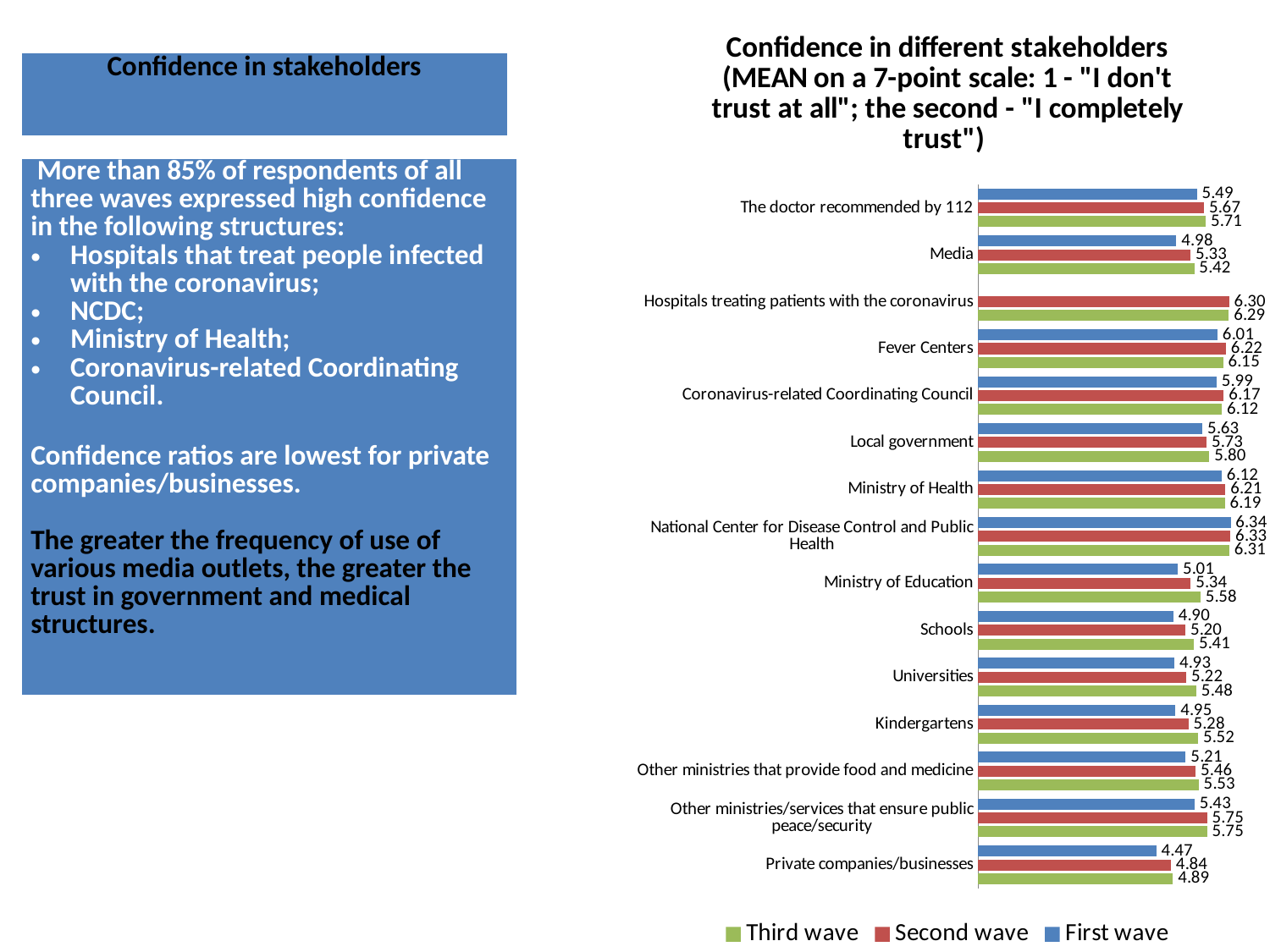
How many series does the chart legend list? 3 Which category has the lowest Third wave value? Private companies/businesses What is the Second wave value for Other ministries/services that ensure public peace/security? 5.75 Which has the larger Second wave value, Local government or Kindergartens? Local government What is the Second wave value for Coronavirus-related Coordinating Council? 6.17 What kind of chart is shown on the slide? Bar chart What is the Third wave value for Media? 5.42 What colour represents the Third wave series in the chart? Green Which category has the highest First wave value? National Center for Disease Control and Public Health What is the difference between the Third wave and First wave values for Ministry of Education? 0.57 What is the First wave value for Private companies/businesses? 4.47 How many stakeholder categories are plotted on the chart? 15